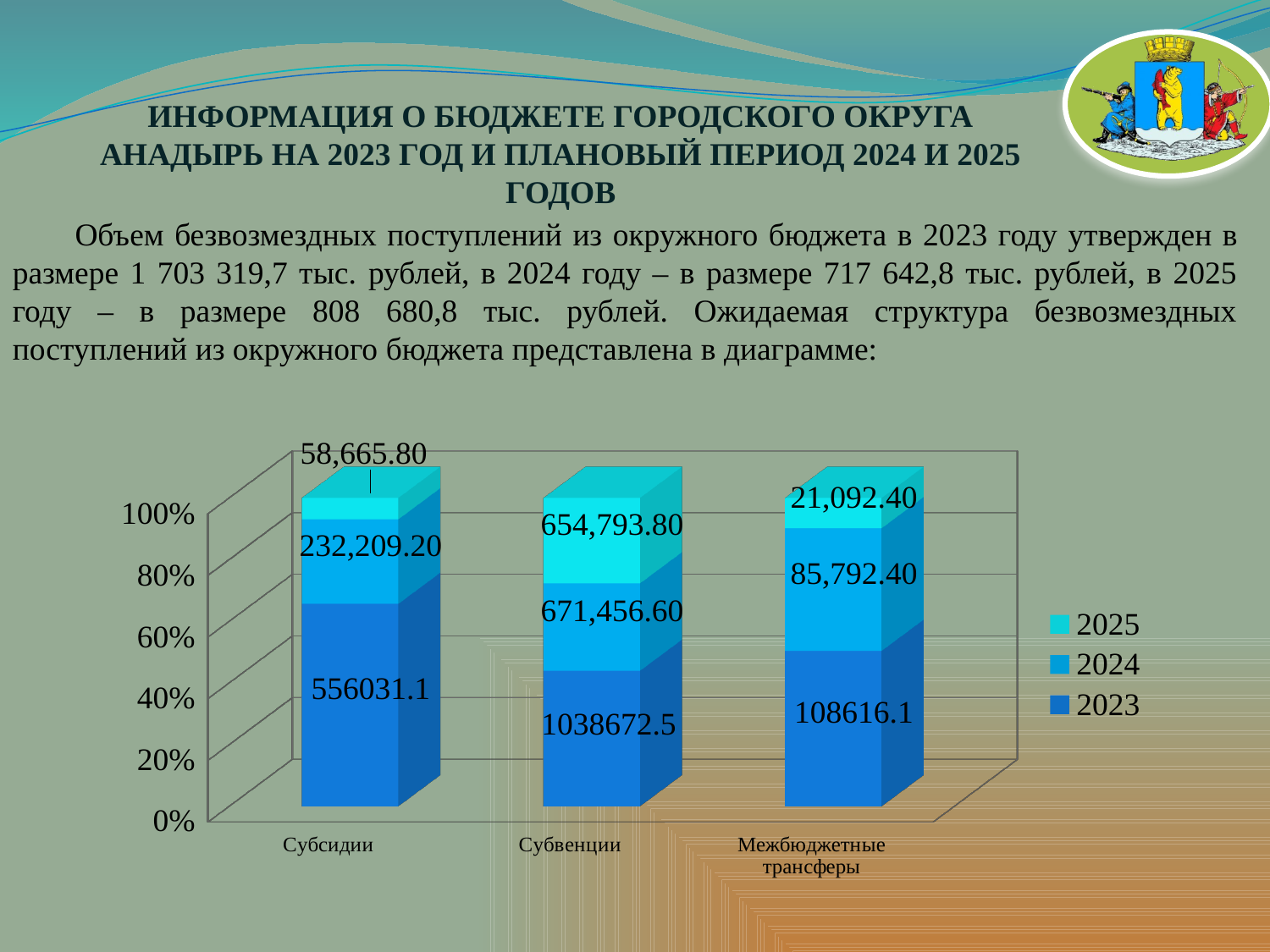
What is the value for 2025 in the Субсидии category? 58,665.80 What is the value for 2025 in the Межбюджетные трансферы category? 21,092.40 How many series does the chart legend list? 3 What is the difference between the 2024 values for Субвенции and Субсидии? 439,247.40 Which is larger: the 2024 value for Субсидии or the 2024 value for Межбюджетные трансферы? Субсидии Which category has the lowest value for the 2025 series? Межбюджетные трансферы What kind of chart is shown on the slide? Stacked bar chart How many categories are shown on the x axis of the chart? 3 Which series is shown in the darkest blue colour in the legend? 2023 Which category has the highest value for the 2023 series? Субвенции What is the value for 2023 in the Субсидии category? 556031.1 What is the value for 2024 in the Субвенции category? 671,456.60